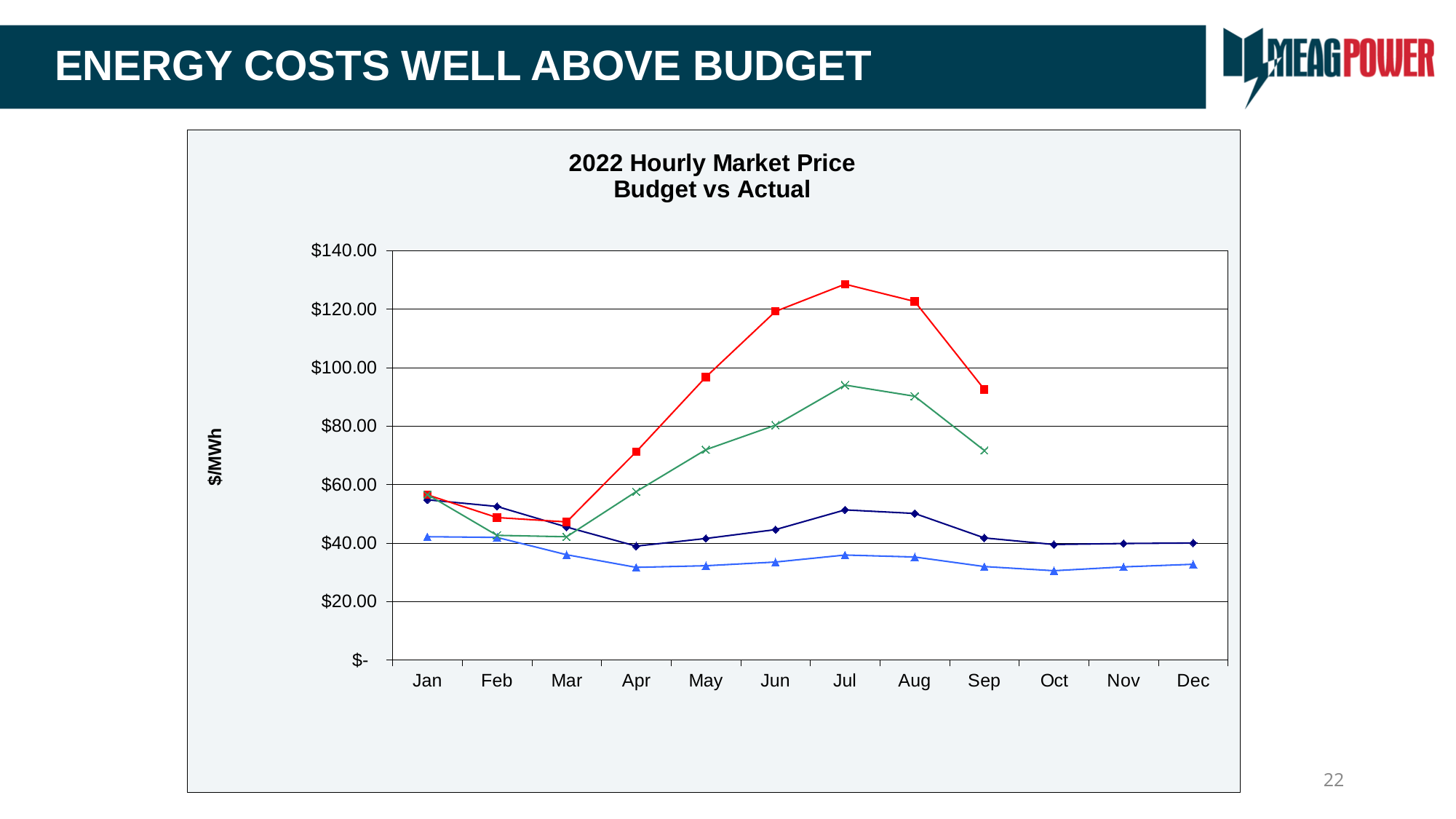
In which month does the red line with square markers reach its highest value? Jul How many lines are plotted on the chart? 4 Is the value of the green line with x markers in Jul greater or less than $100.00? less What is the title of the chart? 2022 Hourly Market Price Budget vs Actual Is the value of the red line with square markers in Jul greater or less than $120.00? greater What is the label on the vertical axis of the chart? $/MWh Is the value of the light blue line with triangle markers in Oct greater or less than $40.00? less Does the red line with square markers rise or fall from Mar to Jul? Rise How many months are shown on the x axis of the chart? 12 In Jul, which is higher: the red line with square markers or the green line with x markers? The red line with square markers What kind of chart is shown on the slide? Line chart